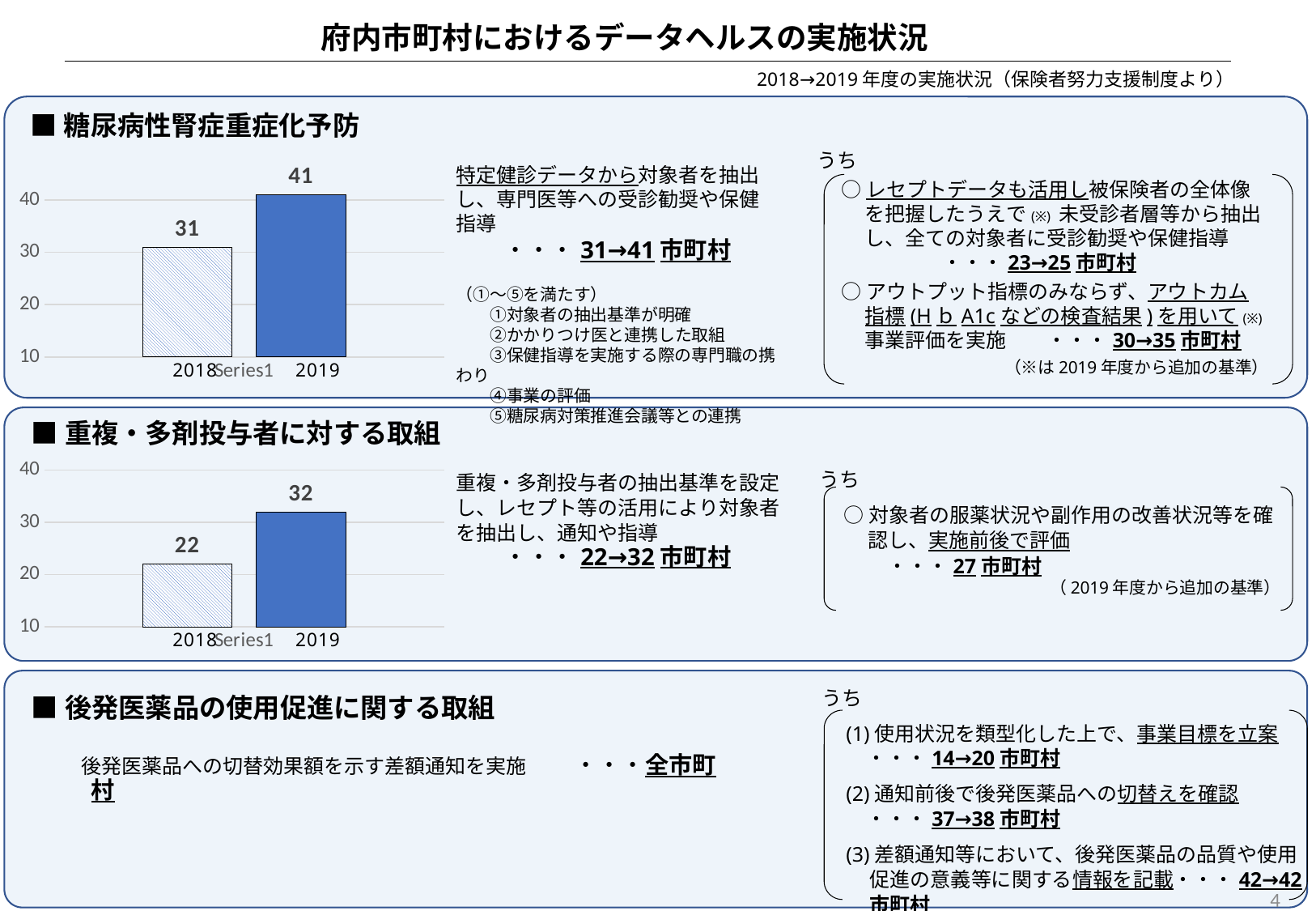
What type of chart is the middle chart (重複・多剤投与者に対する取組)? bar chart In the top chart (糖尿病性腎症重症化予防), by how much does the 2019 value exceed the 2018 value? 10 In the top chart (糖尿病性腎症重症化予防), is the value for 2019 greater or less than 40? greater In the top chart (糖尿病性腎症重症化予防), which year has the higher value? 2019 In the middle chart (重複・多剤投与者に対する取組), which year has the lower value? 2018 In the middle chart (重複・多剤投与者に対する取組), what is the value for 2019? 32 In the middle chart (重複・多剤投与者に対する取組), what is the difference between the 2019 and 2018 values? 10 In the top chart (糖尿病性腎症重症化予防), what is the value for 2018? 31 In the middle chart (重複・多剤投与者に対する取組), what is the value for 2018? 22 In the top chart (糖尿病性腎症重症化予防), what is the value for 2019? 41 In the middle chart (重複・多剤投与者に対する取組), do the values rise or fall from 2018 to 2019? rise How many bars are plotted in the top chart (糖尿病性腎症重症化予防)? 2